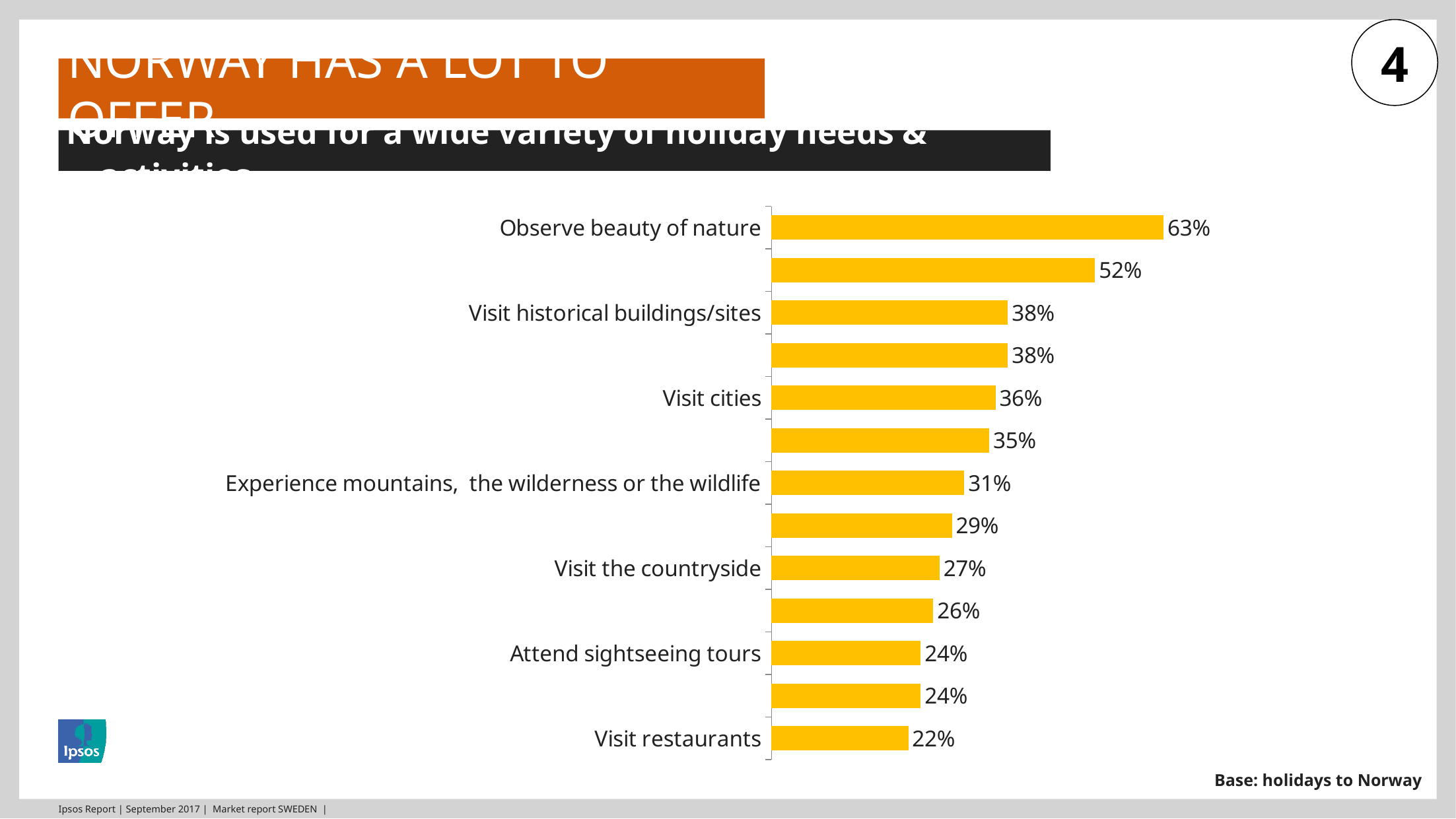
What is the difference in percentage points between "Observe beauty of nature" and "Visit the countryside"? 36 What percentage is shown for "Visit restaurants"? 22% Which labelled activity has the highest percentage? Observe beauty of nature What percentage is shown for "Visit historical buildings/sites"? 38% What kind of chart is shown on the slide? Bar chart What colour are the bars in the chart? Yellow What percentage is shown for "Visit cities"? 36% What percentage is shown for "Experience mountains, the wilderness or the wildlife"? 31% How many bars are plotted in the chart? 13 Which is larger: the value for "Visit cities" or the value for "Attend sightseeing tours"? Visit cities What percentage is shown for "Observe beauty of nature"? 63% Which labelled activity has the lowest percentage? Visit restaurants